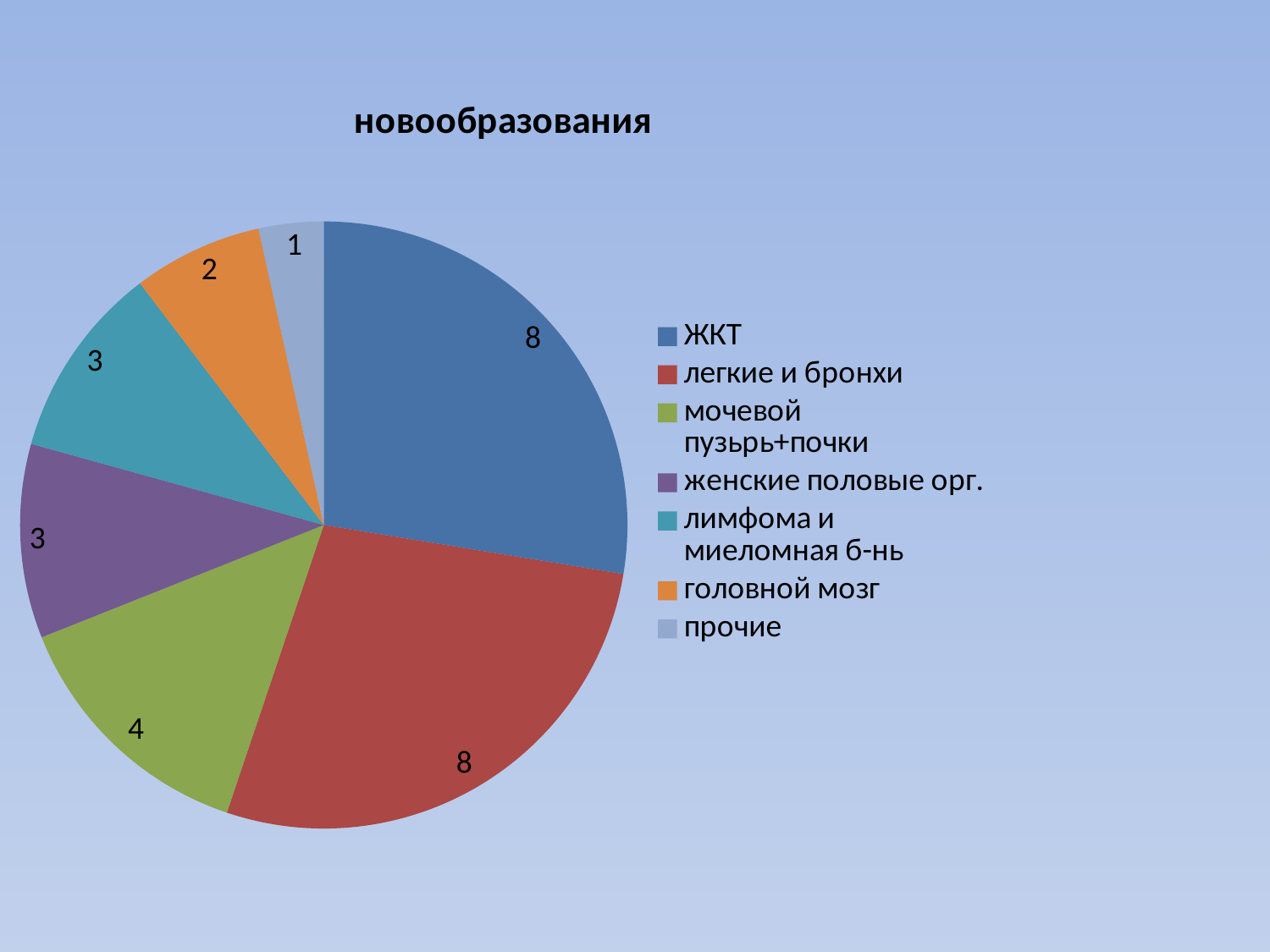
What kind of chart is shown on the slide? pie chart What is the sum of all the values shown in the pie chart? 29 What is the value for мочевой пузырь+почки? 4 How many categories does the pie chart have? 7 What colour is the slice for лимфома и миеломная б-нь? teal What is the difference between the value for легкие и бронхи and the value for женские половые орг.? 5 Which is larger, the value for ЖКТ or the value for мочевой пузырь+почки? ЖКТ What is the value for ЖКТ? 8 Which category has the smallest slice? прочие What is the title of the chart? новообразования What is the value for легкие и бронхи? 8 What is the value for головной мозг? 2